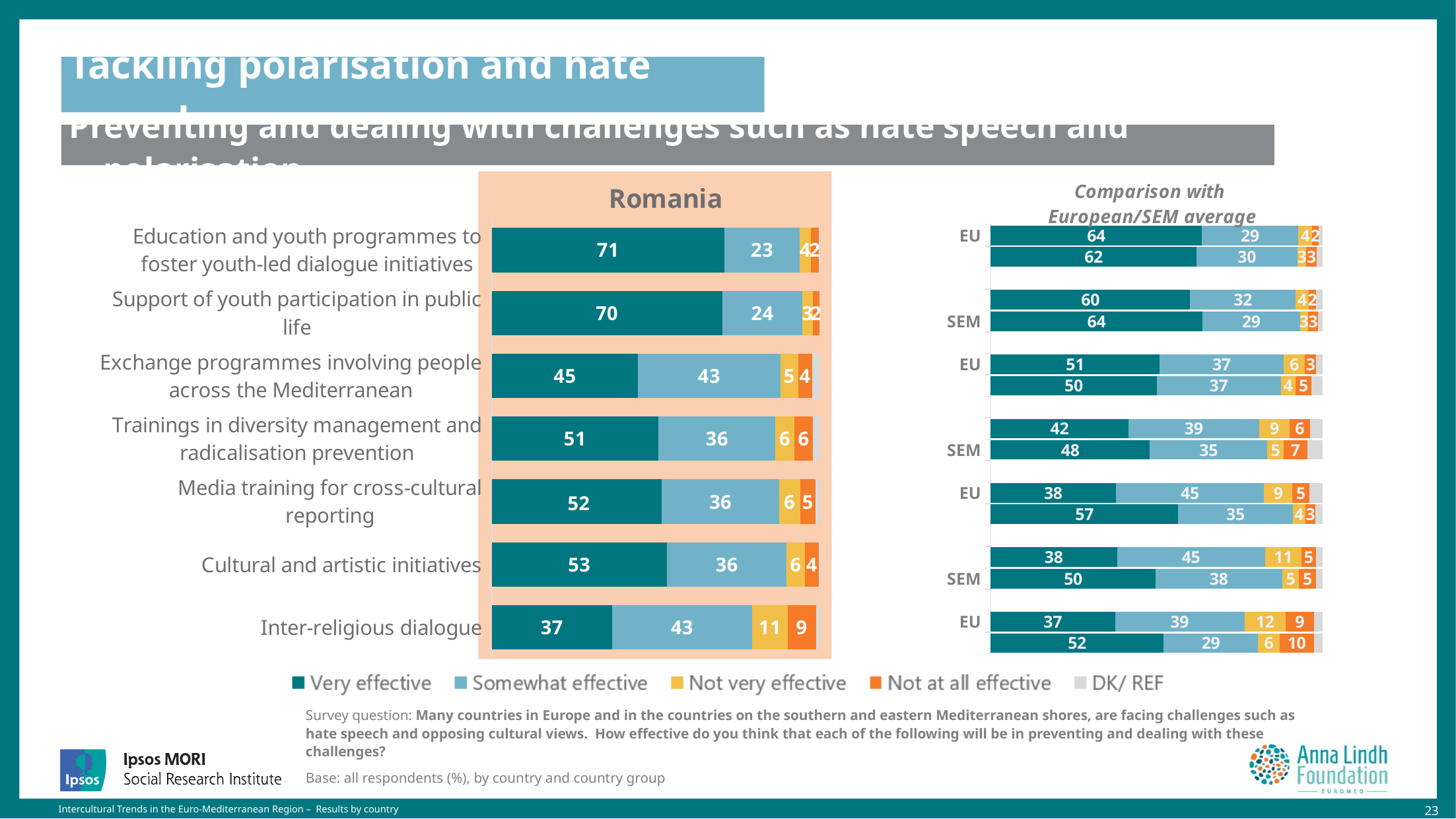
On the Romania chart, which has a larger 'Not very effective' value: 'Inter-religious dialogue' or 'Media training for cross-cultural reporting'? Inter-religious dialogue On the Romania chart, which category has the lowest 'Very effective' value? Inter-religious dialogue On the Romania chart, what is the 'Not at all effective' value for 'Trainings in diversity management and radicalisation prevention'? 6 On the Romania chart, what is the difference between the 'Very effective' values for 'Cultural and artistic initiatives' and 'Inter-religious dialogue'? 16 On the Romania chart, what percentage rated 'Inter-religious dialogue' as very effective? 37 On the Romania chart, which category has the highest 'Very effective' value? Education and youth programmes to foster youth-led dialogue initiatives On the Romania chart, what percentage rated 'Exchange programmes involving people across the Mediterranean' as somewhat effective? 43 How many series does the legend list? 5 How many categories are shown on the Romania chart? 7 What kind of chart is the Romania chart? Stacked bar chart On the 'Comparison with European/SEM average' chart, what is the 'Very effective' value for the EU in the top row? 64 Which colour represents 'Very effective' in the legend? Dark teal